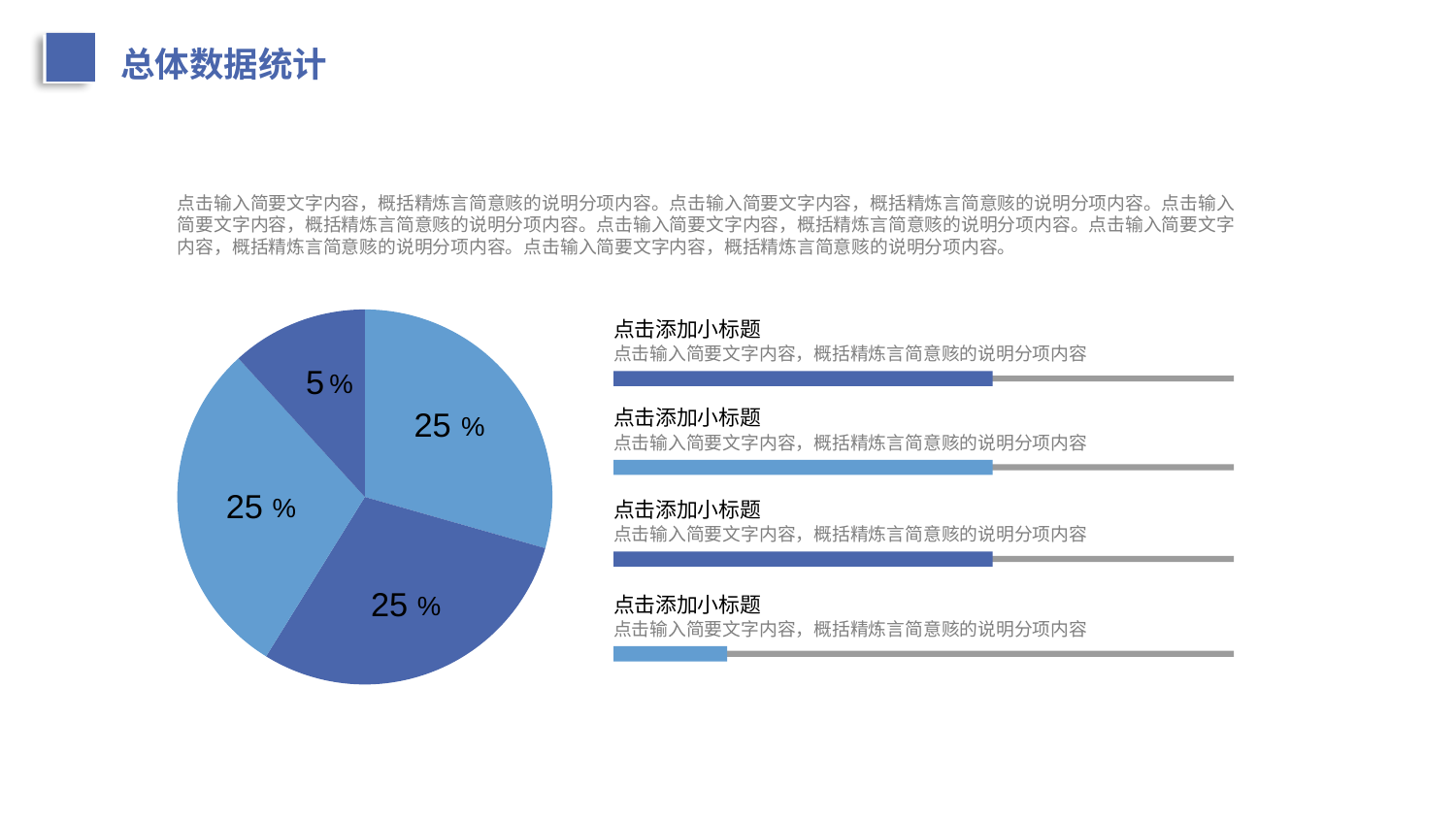
What value is printed on the top-right slice of the pie chart? 25 % What is the value shown on the smallest slice of the pie chart? 5 % Which is larger, the top-right slice or the small top slice of the pie chart? the top-right slice What is the difference between the value of the bottom slice and the value of the small top slice? 20 % What value is printed on the bottom slice of the pie chart? 25 % How many slices of the pie chart are labelled 25 %? 3 How many different colours are used for the slices of the pie chart? 2 What is the title of the slide containing the pie chart? 总体数据统计 What value is printed on the left slice of the pie chart? 25 % How many slices does the pie chart have? 4 What value is printed on the small dark-blue slice at the top of the pie chart? 5 % What kind of chart is shown on the slide? pie chart